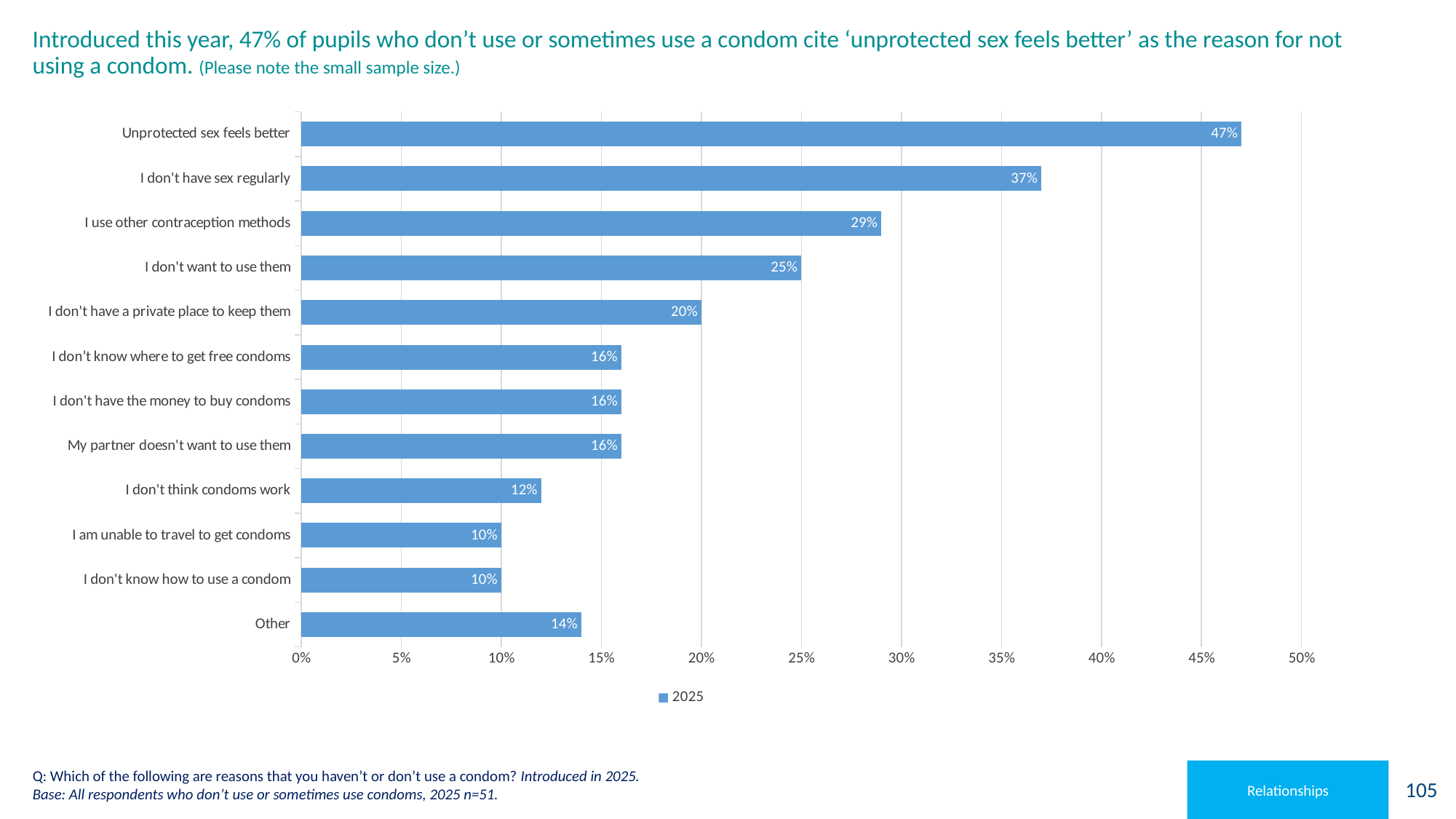
Which reason has the highest percentage? Unprotected sex feels better What kind of chart is shown on the slide? Bar chart What is the value for 'I use other contraception methods'? 29% Which is larger: 'I don't have sex regularly' or 'I use other contraception methods'? I don't have sex regularly What is the value for 'Other'? 14% What percentage of pupils cite 'Unprotected sex feels better' as a reason for not using a condom? 47% Is the value for 'I don't have sex regularly' greater or less than 35%? greater What is the difference between 'Unprotected sex feels better' and 'I don't have sex regularly'? 10 percentage points How many series does the legend list? 1 What is the value for 'I don't have a private place to keep them'? 20% What is the difference between 'I don't want to use them' and 'I don't think condoms work'? 13 percentage points How many reasons (categories) are shown in the chart? 12